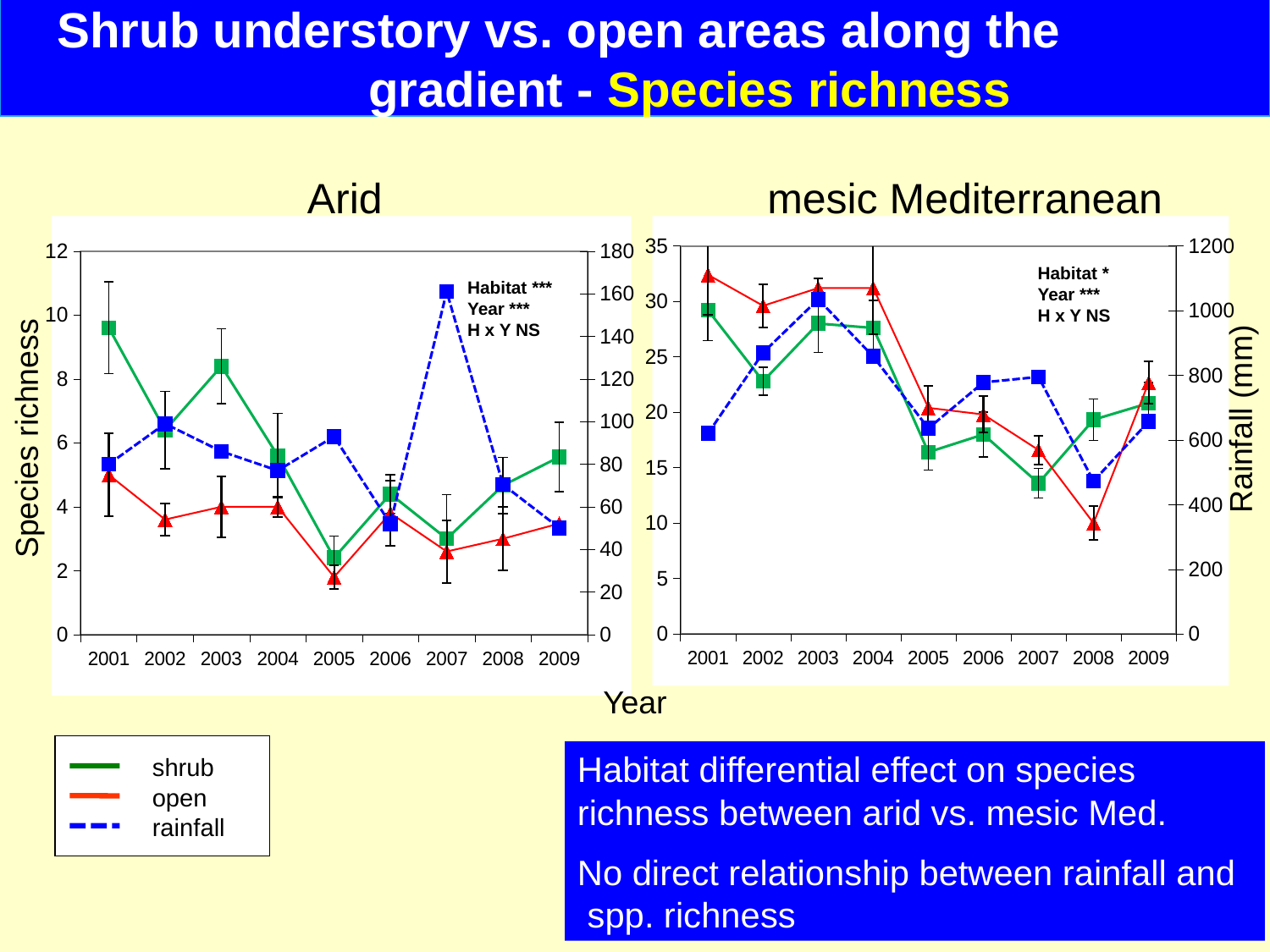
In the mesic Mediterranean chart, does the open species richness rise or fall from 2004 to 2008? fall In the Arid chart, is the rainfall value for 2007 greater or less than 140? greater In the mesic Mediterranean chart, in which year is the open species richness lowest? 2008 In the Arid chart, which is larger in 2001, shrub or open species richness? shrub In the Arid chart, in which year is the rainfall highest? 2007 In the mesic Mediterranean chart, is the open species richness value for 2008 greater or less than 15? less In the Arid chart, in which year is the open species richness lowest? 2005 What kind of chart is the Arid chart? line chart How many years are plotted on the x axis of the mesic Mediterranean chart? 9 In the Arid chart, is the shrub species richness value for 2001 greater or less than 8? greater In the mesic Mediterranean chart, in which year is the rainfall highest? 2003 How many series does the legend list? 3